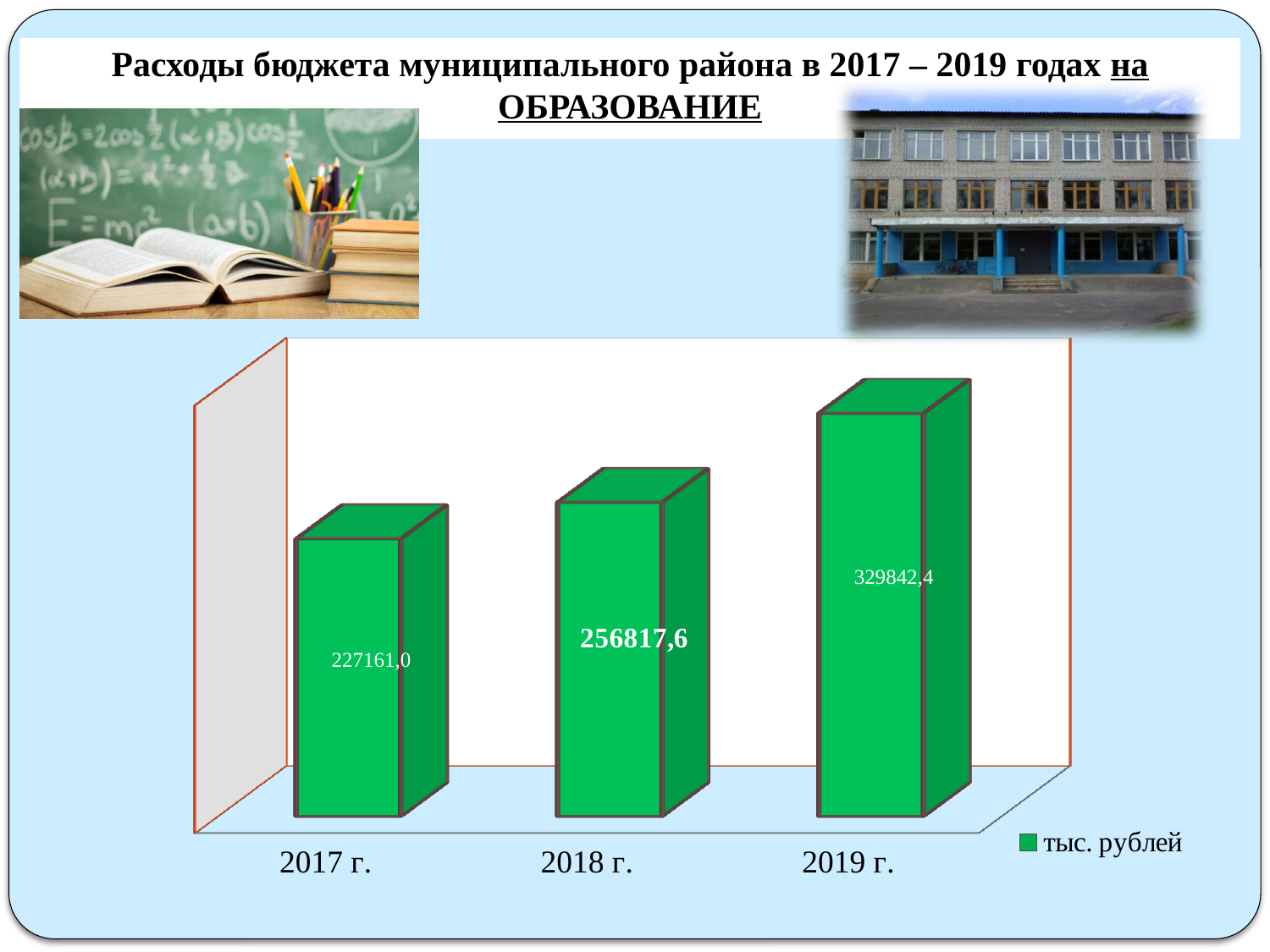
Which is larger, the value for 2019 г. or the value for 2017 г.? 2019 г. What is the value for 2018 г.? 256817,6 What is the difference between the values for 2018 г. and 2017 г.? 29656,6 Do the values rise or fall from 2017 г. to 2019 г.? rise Which year has the highest value? 2019 г. Which year has the lowest value? 2017 г. How many series does the legend list? 1 What is the value for 2017 г.? 227161,0 What is the value for 2019 г.? 329842,4 What kind of chart is shown on the slide? bar chart How many years are shown on the chart? 3 What is the difference between the values for 2019 г. and 2018 г.? 73024,8